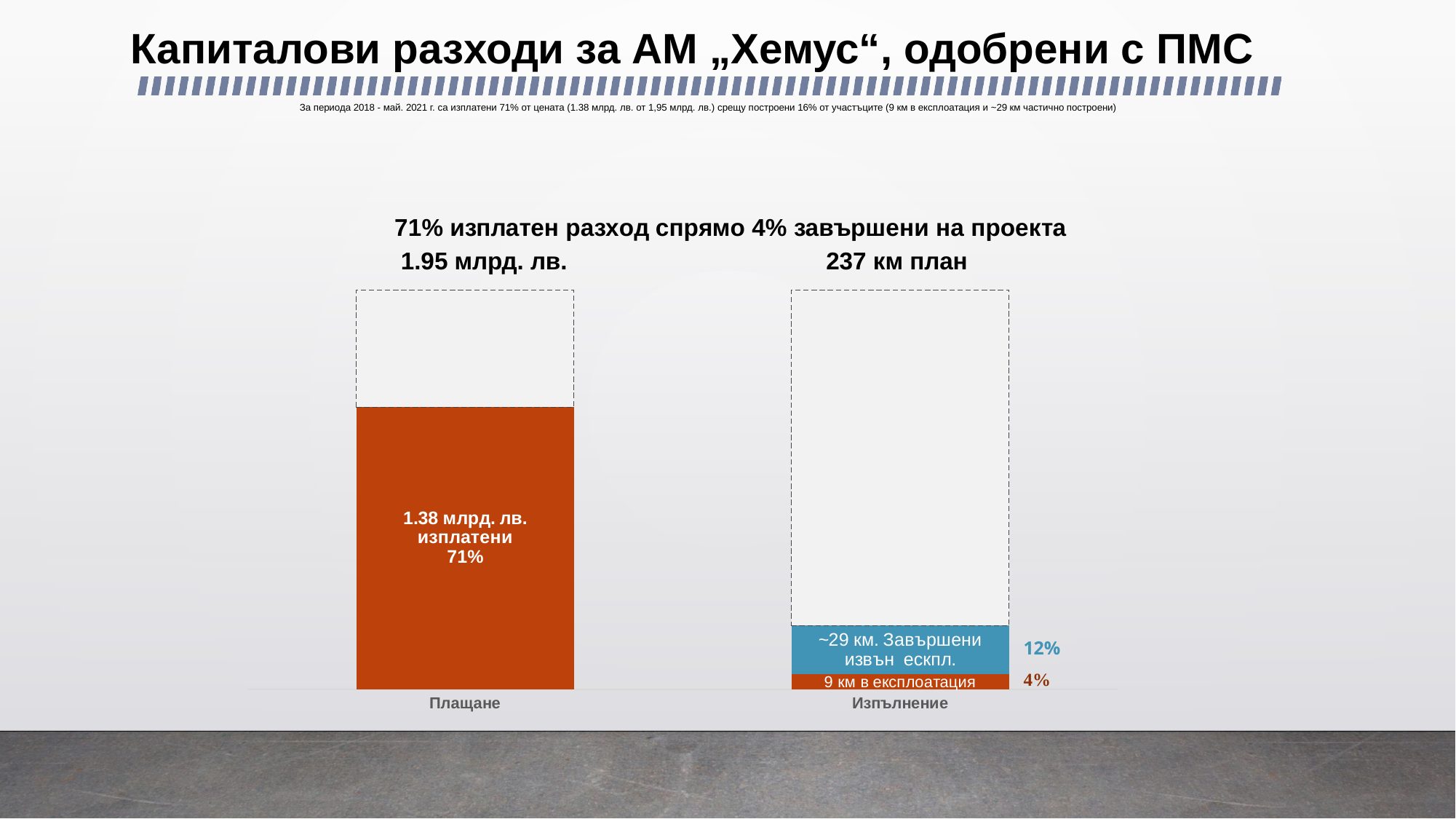
What percentage of the cost has been paid according to the Плащане bar? 71% What is the total planned amount shown above the Плащане bar? 1.95 млрд. лв. What amount is labelled as paid (изплатени) in the Плащане bar? 1.38 млрд. лв. What is the planned length shown above the Изпълнение bar? 237 км план What is the difference in percentage points between the 71% paid and the 4% in operation? 67 What is the chart's title? 71% изплатен разход спрямо 4% завършени на проекта What percentage is labelled next to the '9 км в експлоатация' segment of the Изпълнение bar? 4% What percentage is labelled next to the '~29 км. Завършени извън ескпл.' segment of the Изпълнение bar? 12% What are the two category labels on the x axis of the chart? Плащане and Изпълнение What type of chart is shown on the slide? bar chart Which bar shows the higher completed percentage, Плащане (71%) or the 9 км в експлоатация segment of Изпълнение (4%)? Плащане How many categories are shown on the x axis of the chart? 2